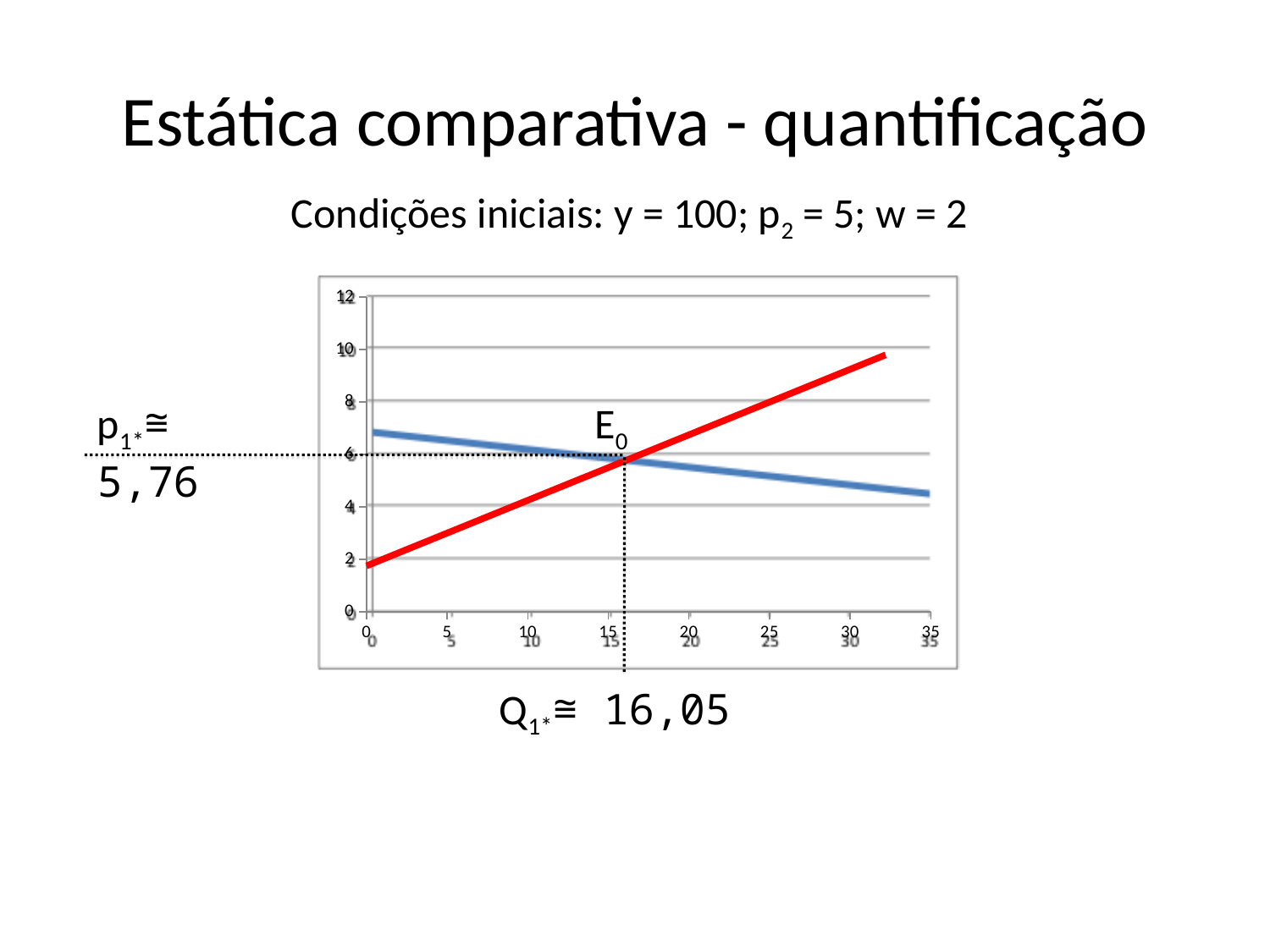
Does the red line rise or fall as the x-axis value increases? rises What value is given on the slide for p1* at the equilibrium? 5,76 What value is given on the slide for Q1* at the equilibrium? 16,05 Is the value of the red line at x = 5 greater or less than 4? less What label marks the intersection point of the two lines? E0 Is the value of the blue line at x = 0 greater or less than 6? greater Does the blue line rise or fall as the x-axis value increases? falls Is the value of the blue line at x = 35 greater or less than 6? less What kind of chart is shown on the slide? line chart What is the highest value shown on the vertical axis of the chart? 12 How many lines are plotted on the chart? 2